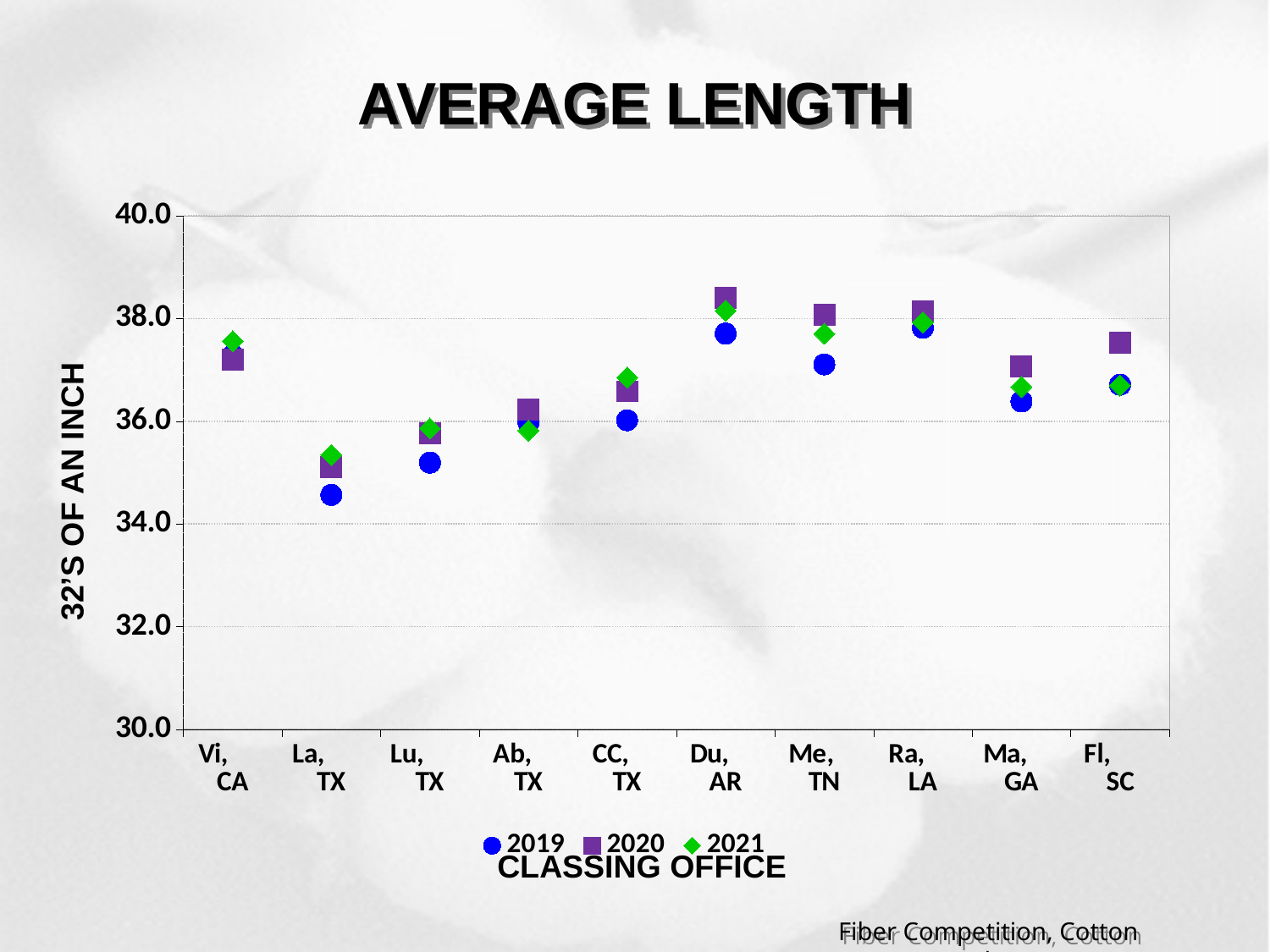
How many series does the legend list? 3 What kind of chart is shown on the slide? Scatter chart Is the 2020 value for Du, AR greater or less than 38.0? greater Is the 2021 value for CC, TX greater or less than 36.0? greater Is the 2019 value for La, TX greater or less than 36.0? less Which is larger, the 2019 value for Me, TN or the 2019 value for Ma, GA? Me, TN Do the 2019 values rise or fall from La, TX to Du, AR? rise What is the title of the chart? AVERAGE LENGTH What is the label on the y axis? 32'S OF AN INCH Which classing office has the lowest 2019 value? La, TX How many classing offices are shown on the x axis? 10 Which classing office has the lowest 2021 value? La, TX